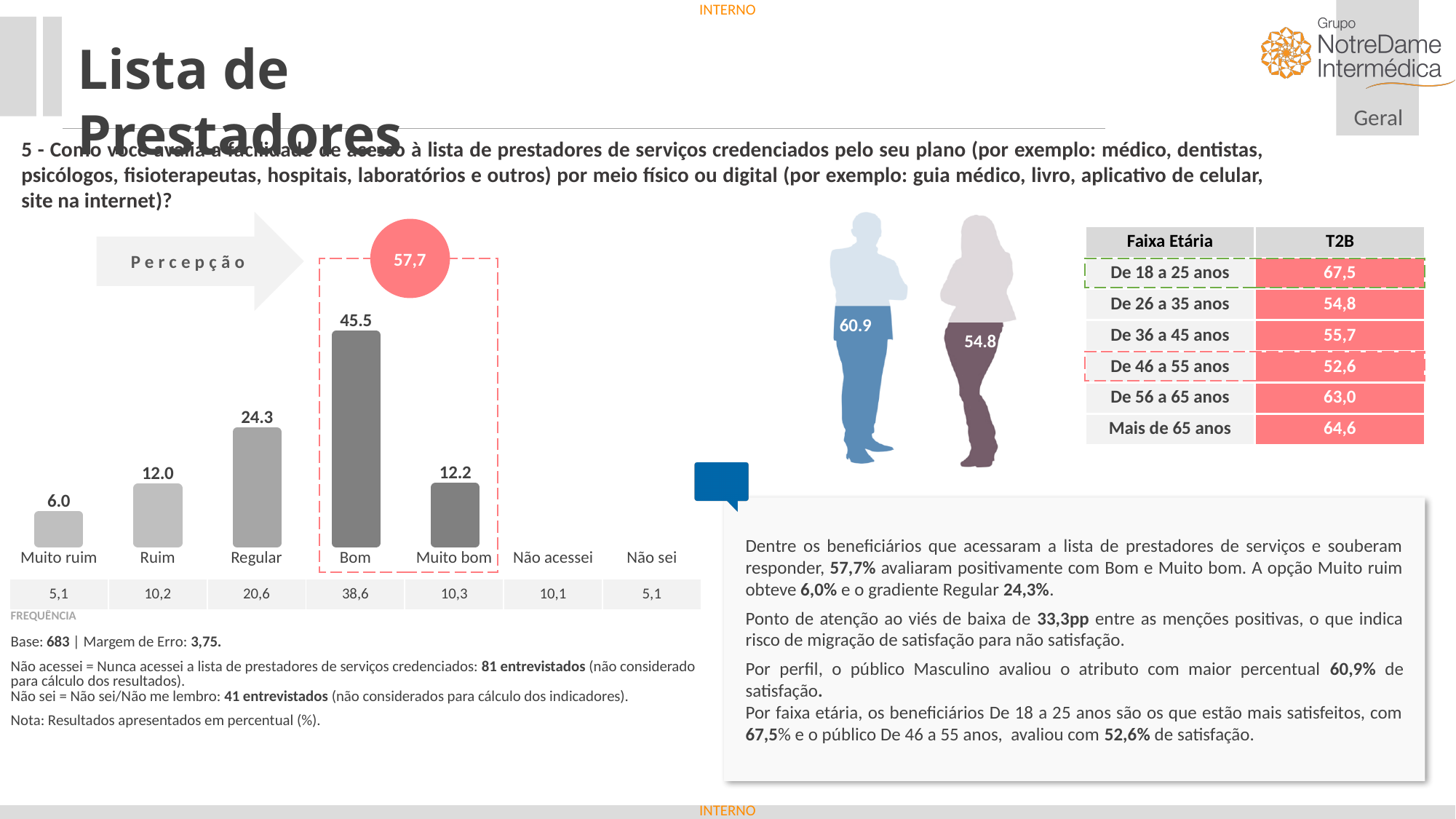
What is the value shown for the "Bom" bar in the bar chart? 45.5 What value is shown in the red circle above the dashed box around "Bom" and "Muito bom" in the bar chart? 57,7 What is the value shown for the "Muito ruim" bar in the bar chart? 6.0 What is the value shown for the "Muito bom" bar in the bar chart? 12.2 How many bars are plotted in the bar chart? 5 Which is larger in the bar chart, the value for "Regular" or the value for "Muito bom"? Regular Which category has the highest bar in the bar chart? Bom What is the difference between the "Bom" and "Regular" values in the bar chart? 21.2 Which category has the lowest bar in the bar chart? Muito ruim What is the value shown for the "Regular" bar in the bar chart? 24.3 What is the difference between the "Ruim" and "Muito ruim" values in the bar chart? 6.0 What kind of chart is shown on the left of the slide? Bar chart